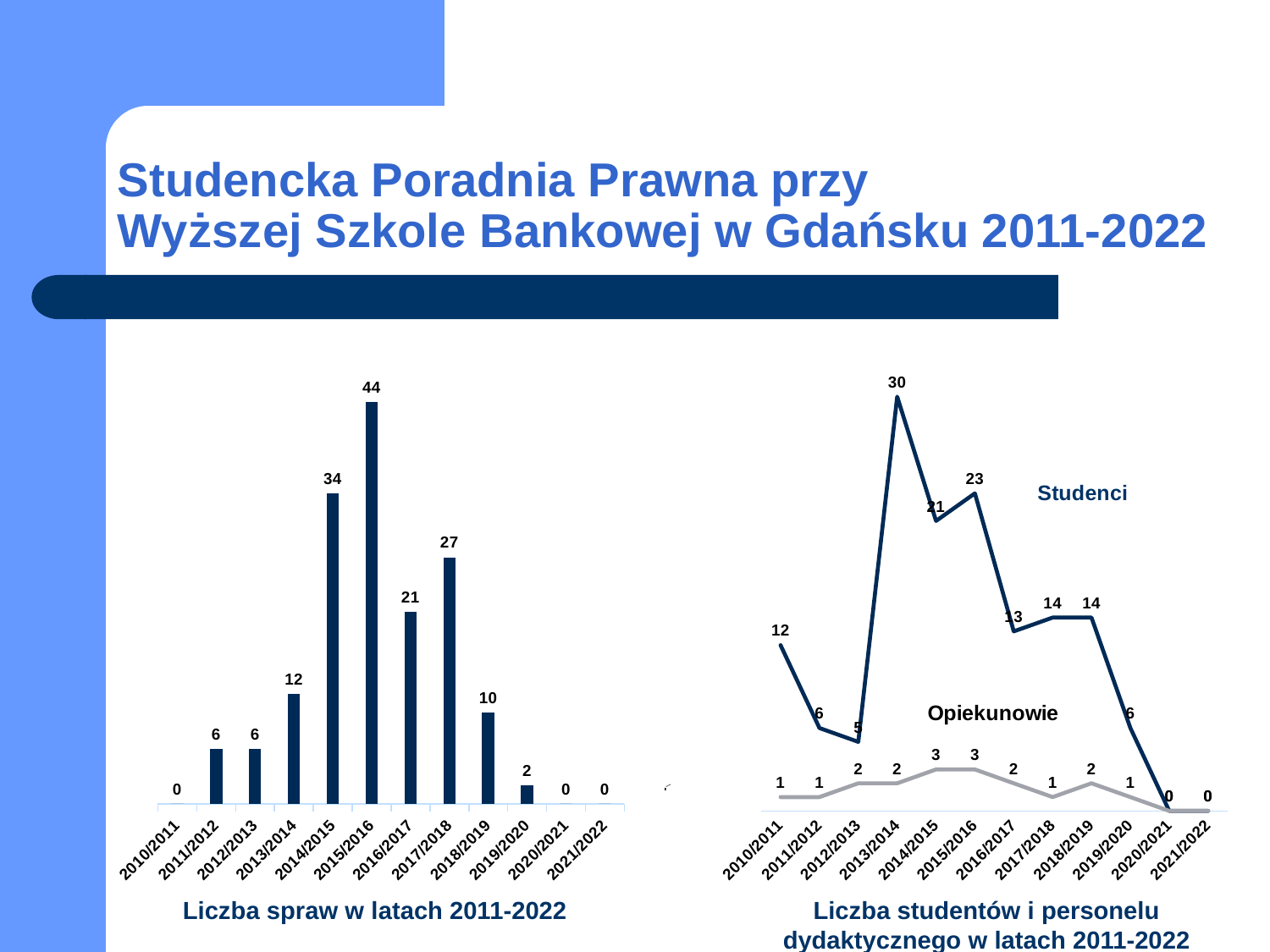
What kind of chart is 'Liczba studentów i personelu dydaktycznego w latach 2011-2022'? line chart In the chart 'Liczba studentów i personelu dydaktycznego w latach 2011-2022', what is the Opiekunowie value for 2014/2015? 3 In the chart 'Liczba spraw w latach 2011-2022', which year has the highest value? 2015/2016 How many categories are shown on the x axis of the chart 'Liczba spraw w latach 2011-2022'? 12 In the chart 'Liczba spraw w latach 2011-2022', what is the difference between the values for 2014/2015 and 2017/2018? 7 In the chart 'Liczba studentów i personelu dydaktycznego w latach 2011-2022', do the Studenci values rise or fall from 2018/2019 to 2020/2021? fall In the chart 'Liczba spraw w latach 2011-2022', which is larger, the value for 2016/2017 or the value for 2018/2019? 2016/2017 What kind of chart is 'Liczba spraw w latach 2011-2022'? bar chart In the chart 'Liczba studentów i personelu dydaktycznego w latach 2011-2022', what is the difference between the Studenci and Opiekunowie values for 2015/2016? 20 In the chart 'Liczba studentów i personelu dydaktycznego w latach 2011-2022', what is the Studenci value for 2013/2014? 30 In the chart 'Liczba spraw w latach 2011-2022', what is the value for 2015/2016? 44 How many series are plotted in the chart 'Liczba studentów i personelu dydaktycznego w latach 2011-2022'? 2